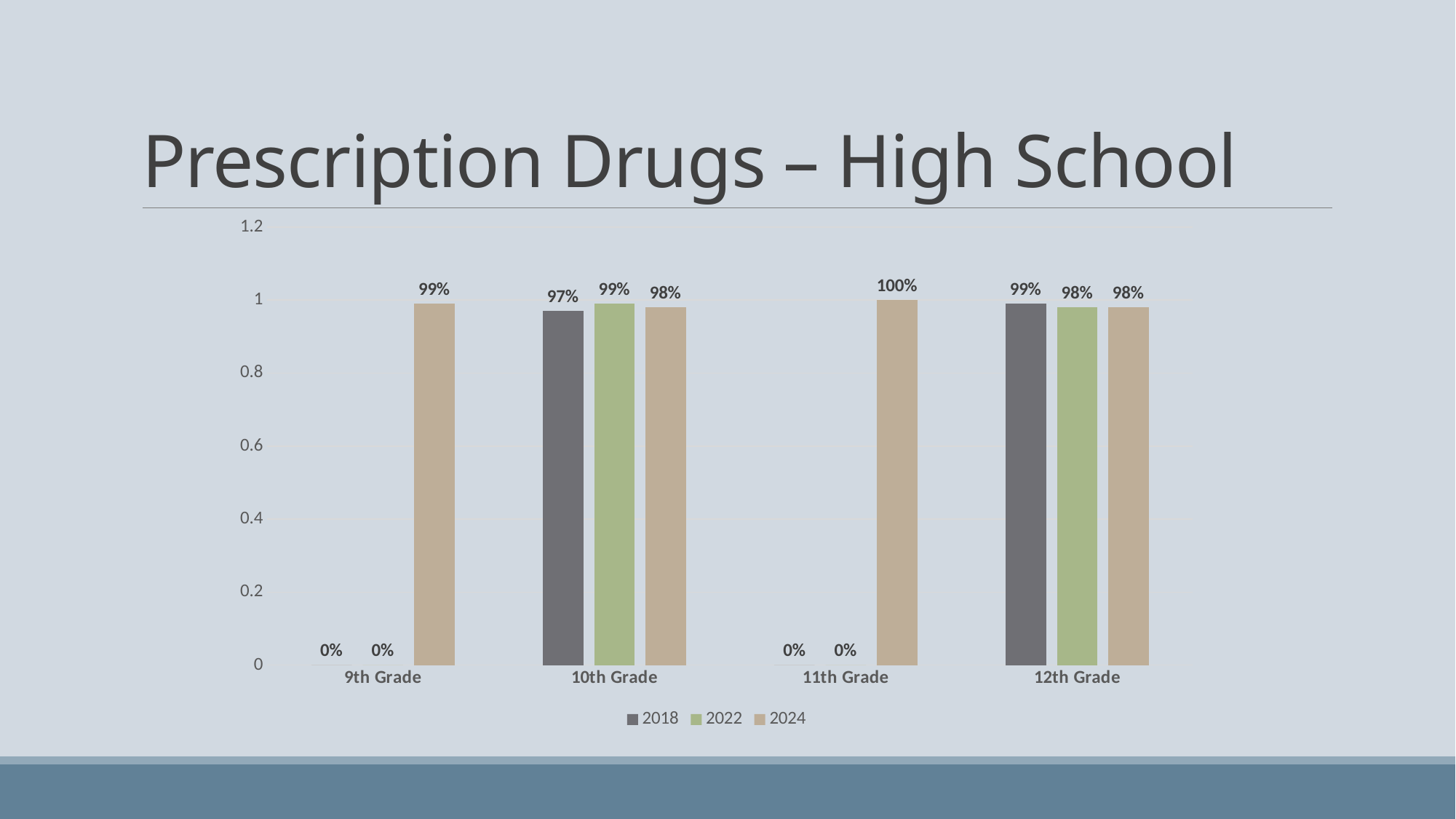
What is the value for 2022 in 12th Grade? 98% How many grade categories are shown on the x axis? 4 What is the value for 2018 in 9th Grade? 0% What kind of chart is shown on the slide? Bar chart Which is larger for 12th Grade, the 2018 value or the 2024 value? 2018 What is the title of the slide? Prescription Drugs – High School Which grade has the highest value for 2024? 11th Grade How many series does the legend list? 3 What is the value for 2018 in 10th Grade? 97% What is the difference between the 2022 and 2018 values for 10th Grade? 2% What is the value for 2024 in 11th Grade? 100% What is the value for 2024 in 9th Grade? 99%